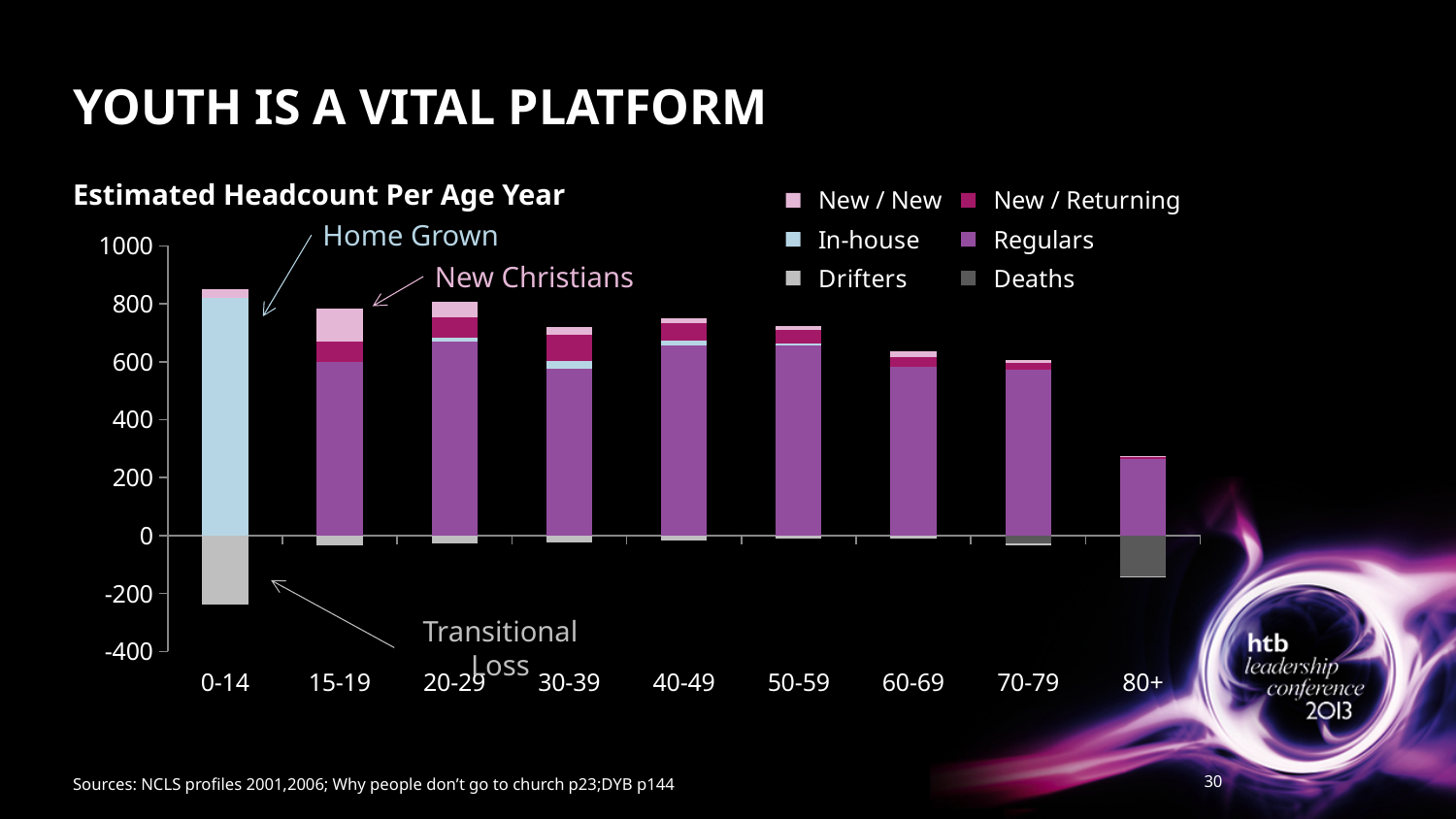
What kind of chart is shown on the slide? stacked bar chart Which age group has a taller bar above zero, 15-19 or 80+? 15-19 Which age group has the tallest bar above zero in the chart? 0-14 Is the total above zero for the 0-14 age group greater or less than 800? greater How many series does the chart's legend list? 6 Is the total above zero for the 30-39 age group greater or less than 600? greater Is the negative portion of the 0-14 bar greater or less than -200? less Do the bar totals above zero generally rise or fall from the 15-19 age group to the 80+ age group? fall What is the title of the chart? Estimated Headcount Per Age Year Which age group has the shortest bar above zero in the chart? 80+ How many age groups are shown on the x axis of the chart? 9